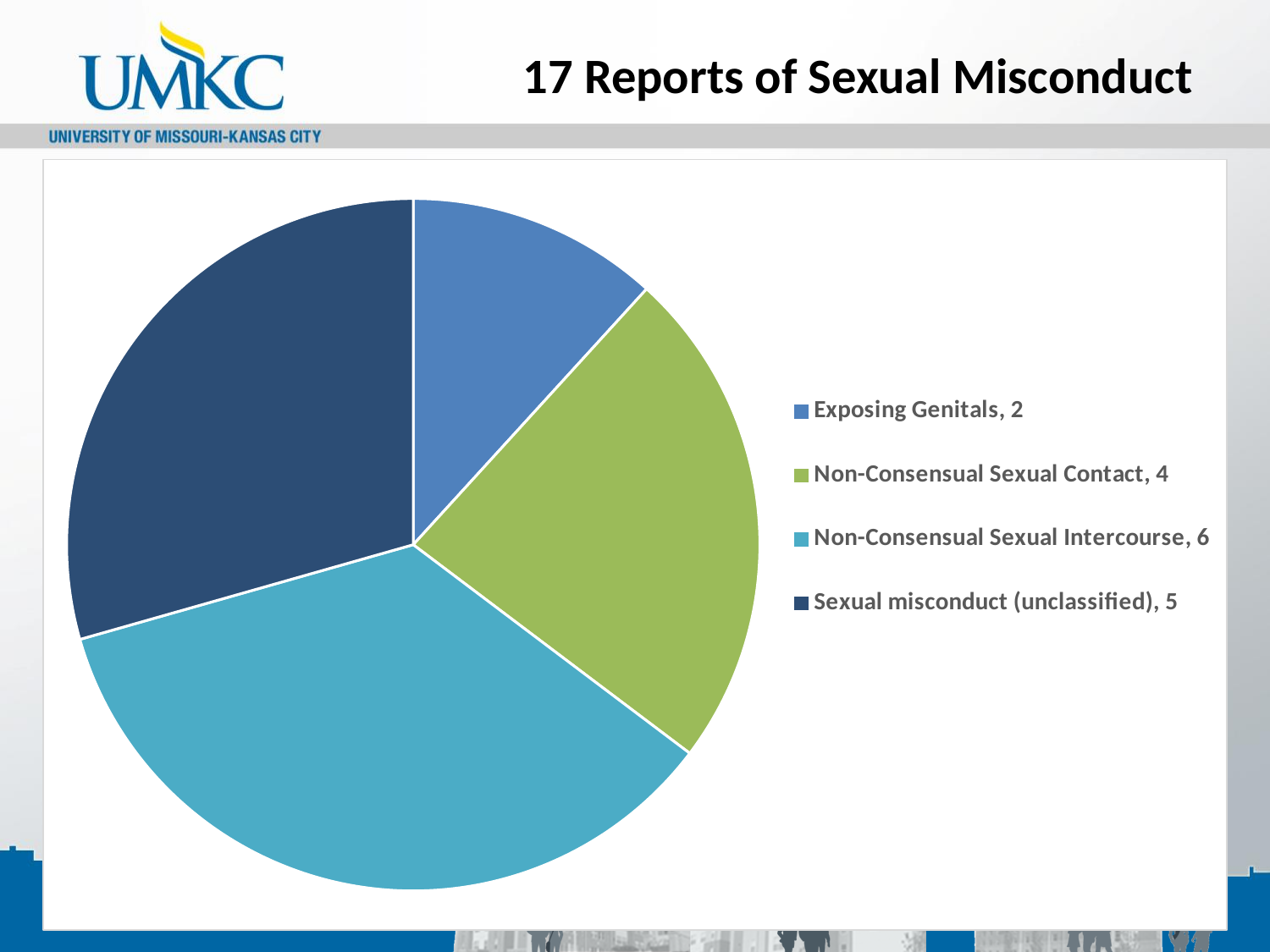
How many reports are in the Non-Consensual Sexual Intercourse category? 6 What is the title of the slide containing the pie chart? 17 Reports of Sexual Misconduct How many reports are in the Exposing Genitals category? 2 How many reports are in the Sexual misconduct (unclassified) category? 5 What kind of chart is shown on the slide? pie chart Which has more reports: Non-Consensual Sexual Contact or Sexual misconduct (unclassified)? Sexual misconduct (unclassified) Which category has the smallest number of reports? Exposing Genitals How many categories does the pie chart show? 4 Which category has the largest number of reports? Non-Consensual Sexual Intercourse What is the total number of reports across all categories in the pie chart? 17 What is the difference between the number of Non-Consensual Sexual Intercourse reports and Exposing Genitals reports? 4 How many reports are in the Non-Consensual Sexual Contact category? 4